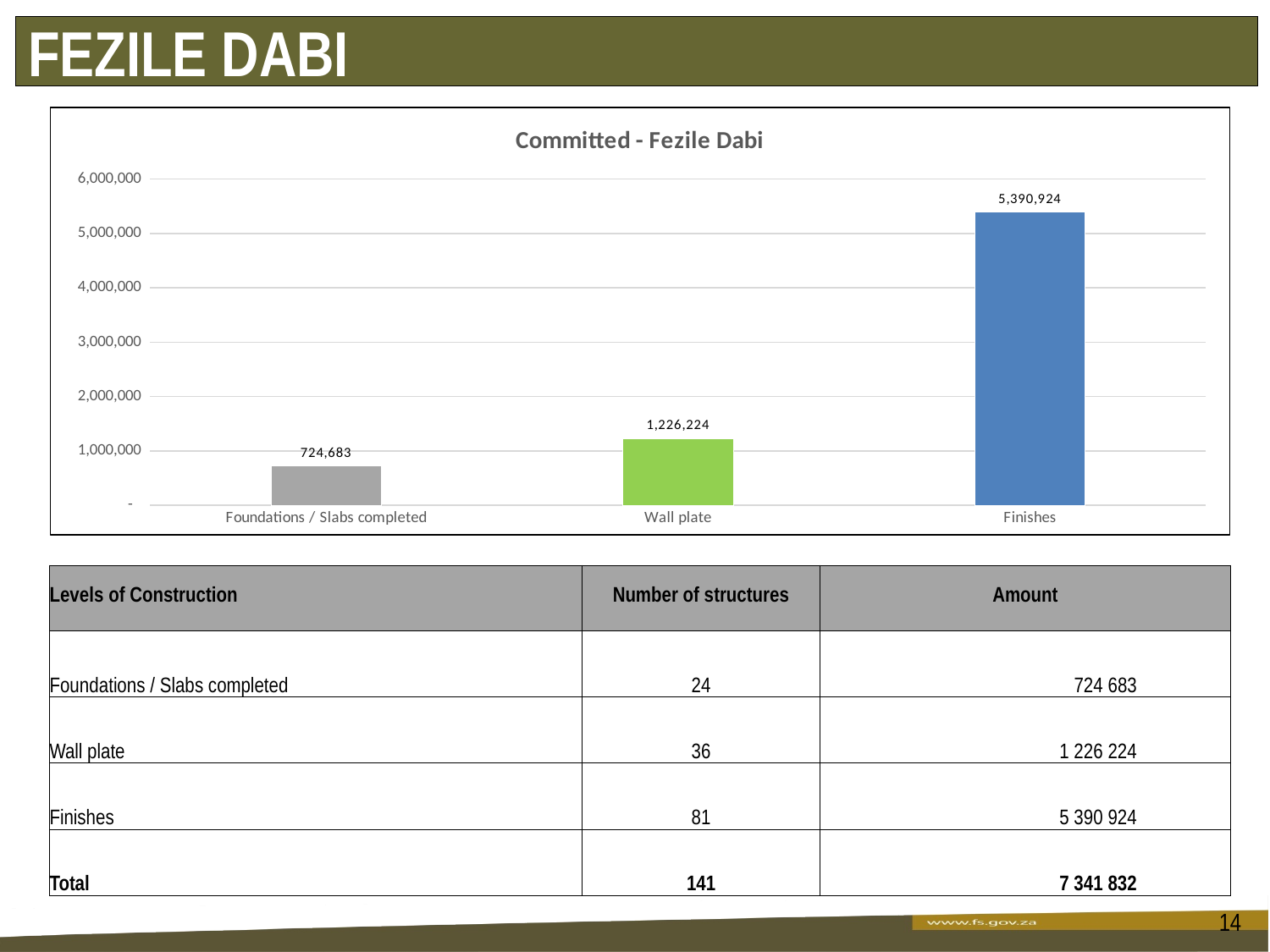
Which category has the highest value in the Committed - Fezile Dabi chart? Finishes Which category has the lowest value in the Committed - Fezile Dabi chart? Foundations / Slabs completed In the Committed - Fezile Dabi chart, which is larger: Wall plate or Foundations / Slabs completed? Wall plate What kind of chart is the Committed - Fezile Dabi chart? bar chart What is the value for Foundations / Slabs completed in the Committed - Fezile Dabi chart? 724,683 What is the difference between the values for Finishes and Wall plate in the Committed - Fezile Dabi chart? 4,164,700 How many categories are shown in the Committed - Fezile Dabi chart? 3 What is the difference between the values for Wall plate and Foundations / Slabs completed in the Committed - Fezile Dabi chart? 501,541 What is the value for Finishes in the Committed - Fezile Dabi chart? 5,390,924 In the Committed - Fezile Dabi chart, is the value for Finishes greater or less than 5,000,000? greater Do the values rise or fall from left to right along the x axis in the Committed - Fezile Dabi chart? rise What is the value for Wall plate in the Committed - Fezile Dabi chart? 1,226,224